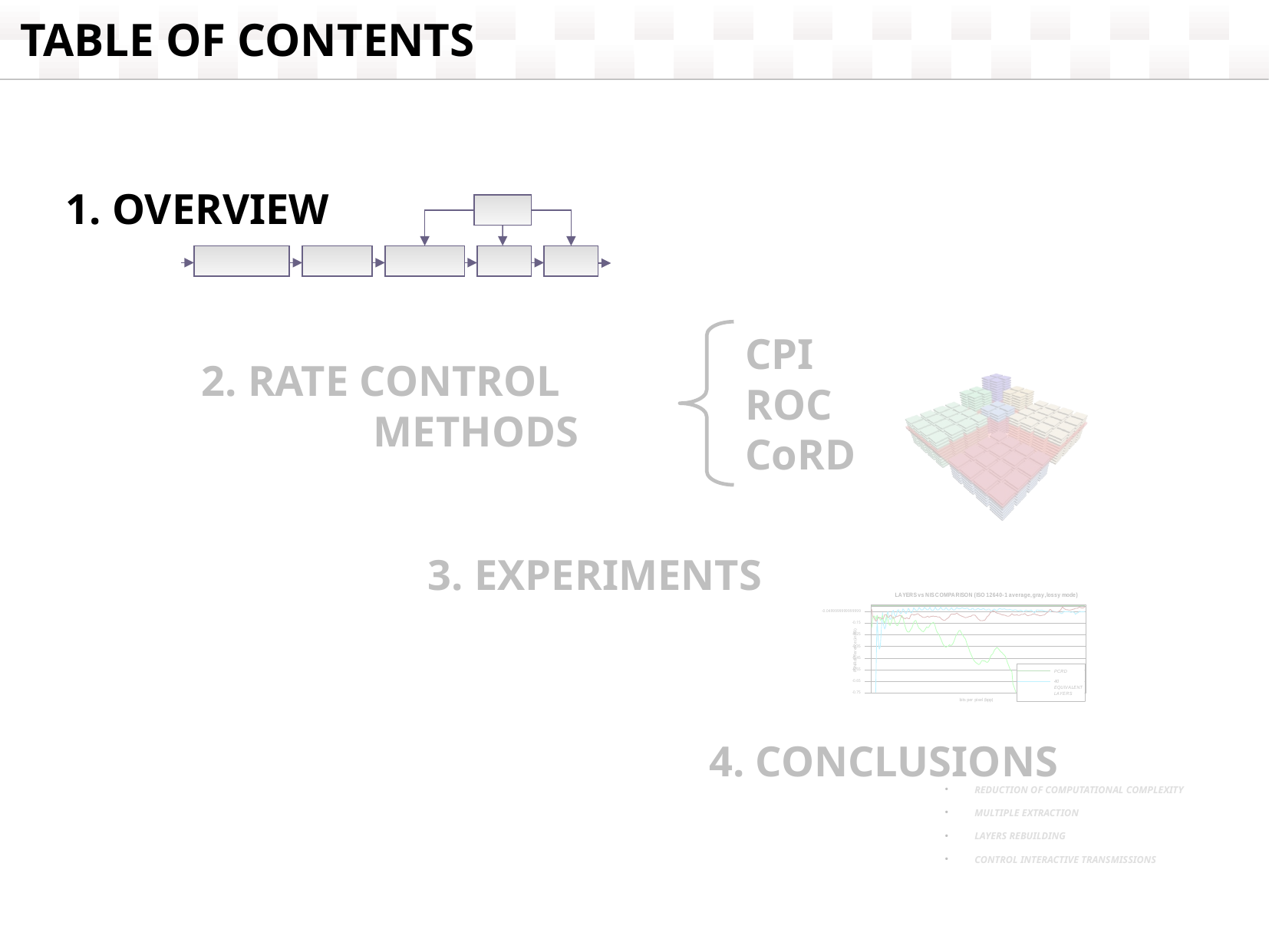
In the line chart under '3. EXPERIMENTS', what is the first entry listed in the legend? PCRD What is the title of the line chart shown under the '3. EXPERIMENTS' heading? LAYERS vs NIS COMPARISON (ISO 12640-1 average, gray, lossy mode) In the line chart under '3. EXPERIMENTS', does the green line rise or fall overall from left to right along the x axis? fall What kind of chart is shown in the small thumbnail under the '3. EXPERIMENTS' heading? line chart